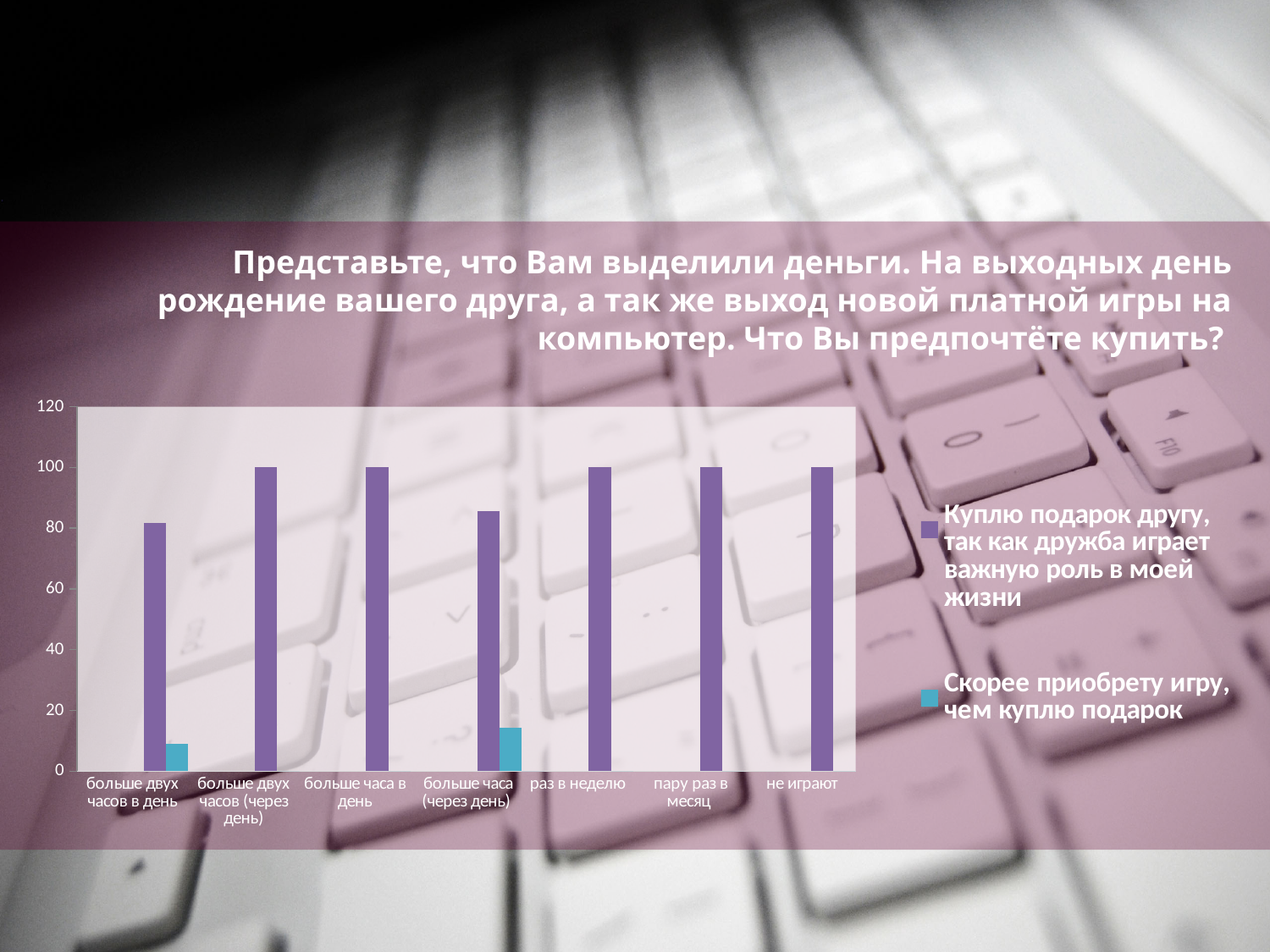
Is the value of the 'Куплю подарок другу' series for 'больше двух часов в день' greater or less than 60? greater Which category has the lowest value for the 'Куплю подарок другу, так как дружба играет важную роль в моей жизни' series? больше двух часов в день How many categories are shown along the x axis of the chart? 7 Is the value of the 'Скорее приобрету игру, чем куплю подарок' series for 'больше часа (через день)' greater or less than 20? less What kind of chart is shown on the slide? bar chart What is the value of the 'Куплю подарок другу, так как дружба играет важную роль в моей жизни' series for the category 'раз в неделю'? 100 For the category 'больше двух часов в день', which series has the larger value: 'Куплю подарок другу' or 'Скорее приобрету игру'? Куплю подарок другу What is the value of the 'Куплю подарок другу, так как дружба играет важную роль в моей жизни' series for the category 'не играют'? 100 For the 'Куплю подарок другу' series, which category has the larger value: 'больше двух часов в день' or 'больше двух часов (через день)'? больше двух часов (через день) How many series does the chart's legend list? 2 What colour are the bars for the 'Скорее приобрету игру, чем куплю подарок' series? teal (blue-green) Which category has the highest value for the 'Скорее приобрету игру, чем куплю подарок' series? больше часа (через день)